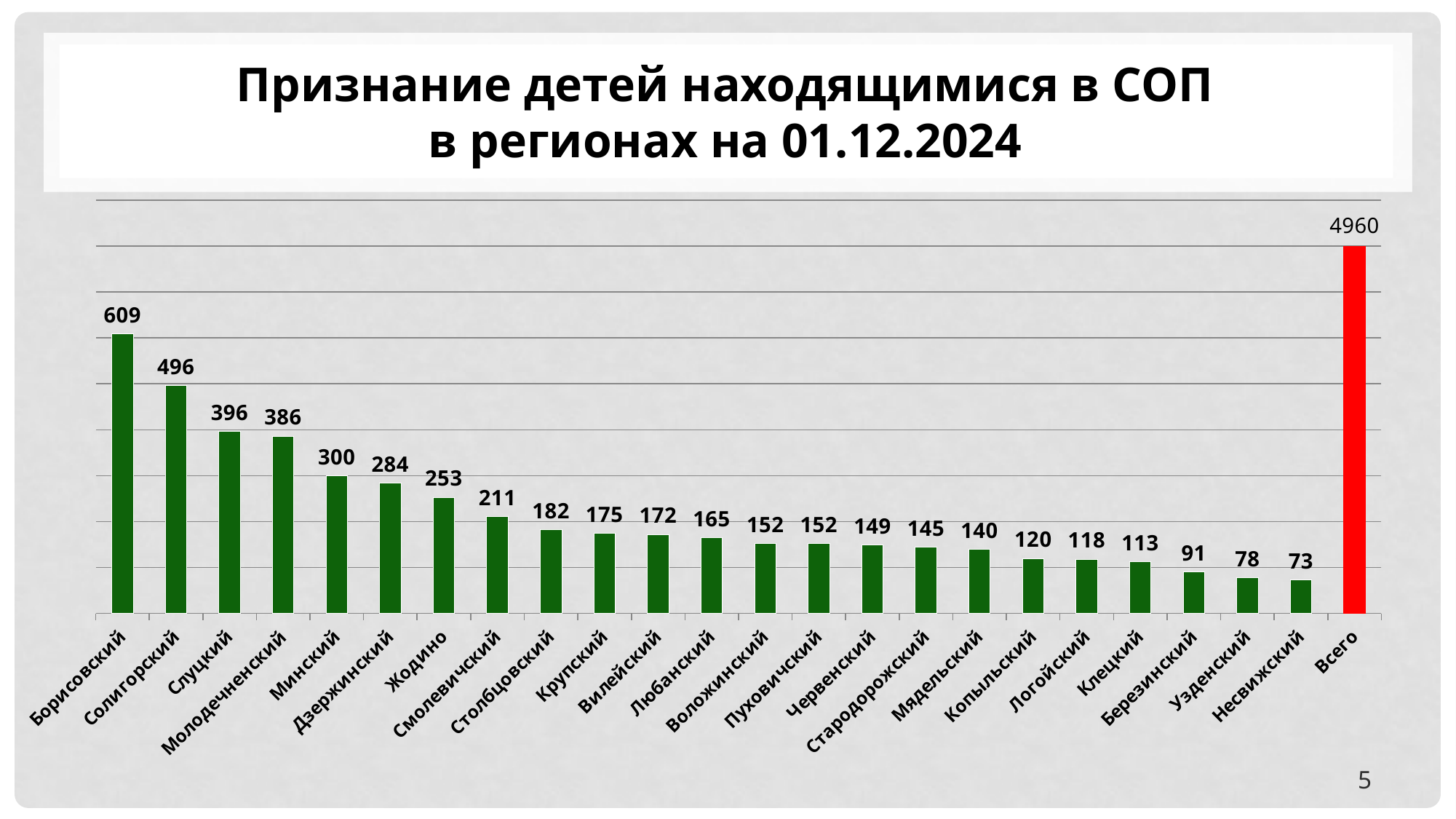
What value is shown for Борисовский? 609 What type of chart is shown on the slide? Bar chart Which has a larger value, Минский or Дзержинский? Минский What value is shown for Несвижский? 73 Which region (excluding Всего) has the highest value? Борисовский How many bars are plotted in the chart, including Всего? 24 What value is shown for Жодино? 253 What colour is the Всего bar? Red What is the difference between the values for Солигорский and Слуцкий? 100 What is the value of the Всего bar? 4960 Which region has the lowest value? Несвижский Do the region values rise or fall from left to right (excluding the Всего bar)? Fall